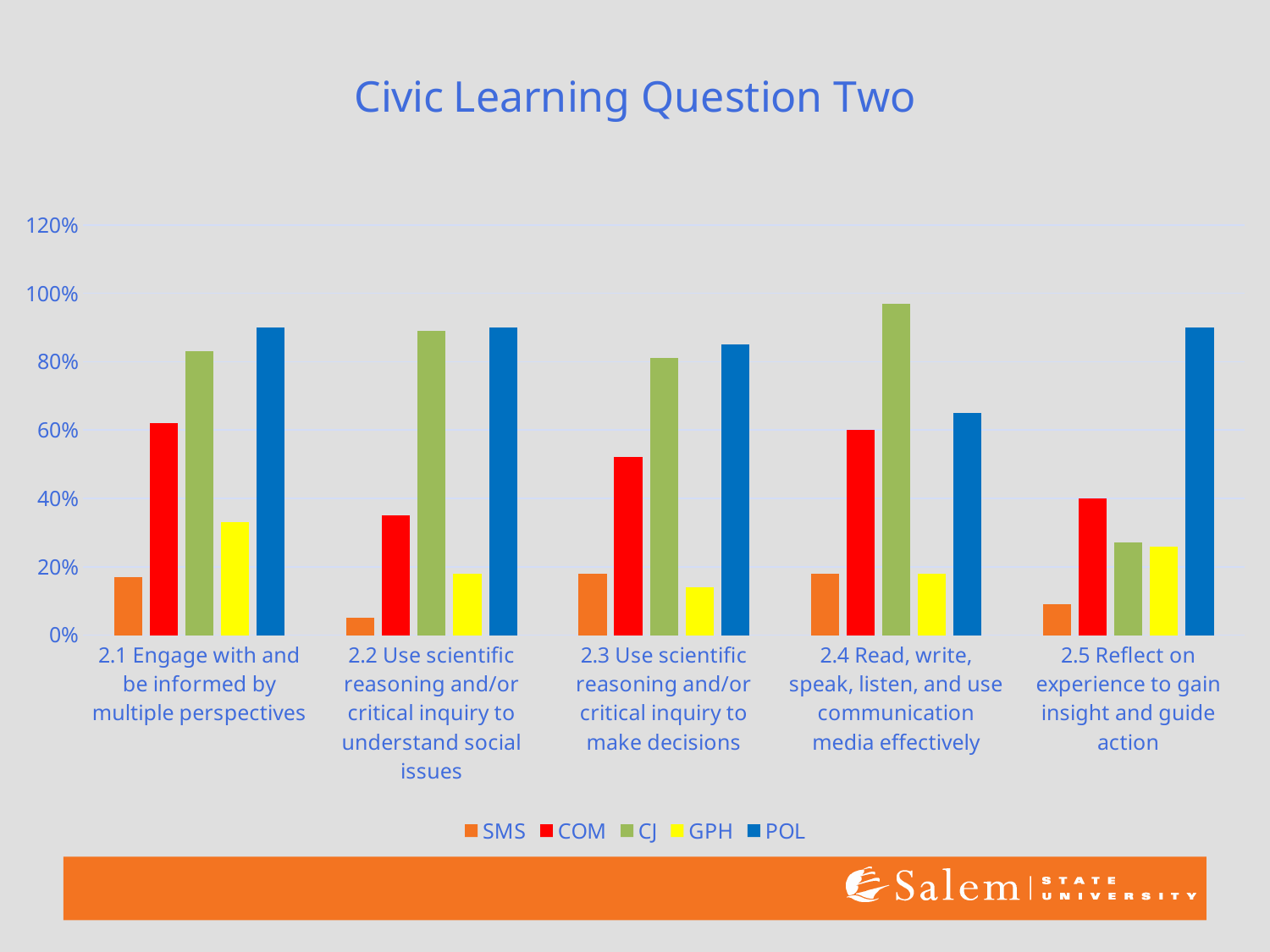
Which series has the highest value for '2.4 Read, write, speak, listen, and use communication media effectively'? CJ Is the value for SMS in '2.2 Use scientific reasoning and/or critical inquiry to understand social issues' greater or less than 20%? less How many series does the legend list? 5 How many categories are shown along the x axis? 5 Which series has the lowest value for '2.2 Use scientific reasoning and/or critical inquiry to understand social issues'? SMS Is the value for POL in '2.4 Read, write, speak, listen, and use communication media effectively' greater or less than 80%? less In '2.5 Reflect on experience to gain insight and guide action', which is larger, COM or CJ? COM Is the value for CJ in '2.4 Read, write, speak, listen, and use communication media effectively' greater or less than 80%? greater What kind of chart is shown on the slide? bar chart Across the categories, which category has the lowest POL value? 2.4 Read, write, speak, listen, and use communication media effectively What is the title of the chart? Civic Learning Question Two